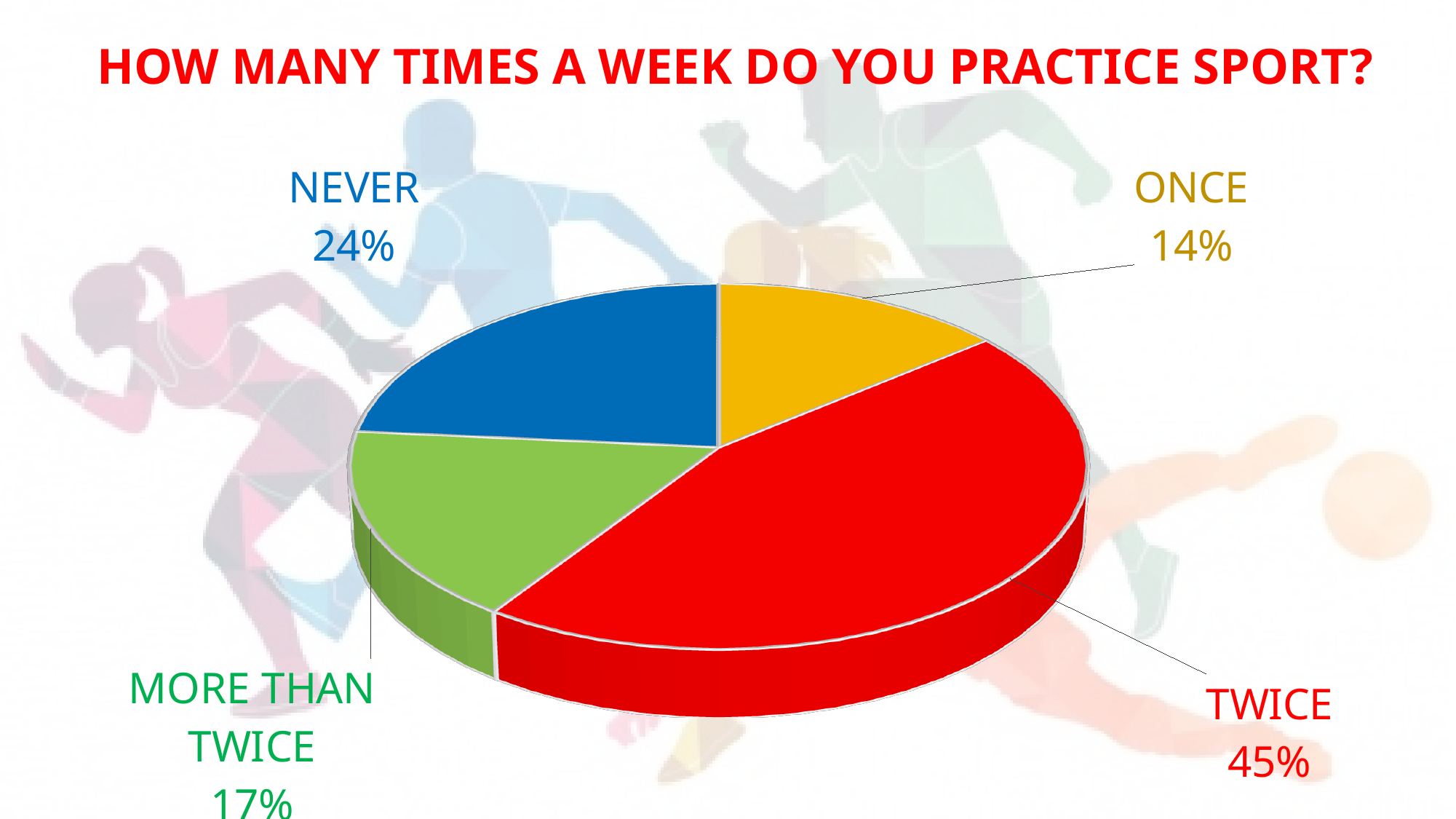
What percentage of respondents answered "TWICE"? 45% What is the title of the chart? HOW MANY TIMES A WEEK DO YOU PRACTICE SPORT? What percentage of respondents answered "MORE THAN TWICE"? 17% What kind of chart is shown on the slide? Pie chart What percentage of respondents answered "ONCE"? 14% What is the difference in percentage points between "TWICE" and "NEVER"? 21 Which is larger, the share for "NEVER" or the share for "MORE THAN TWICE"? NEVER What percentage of respondents answered "NEVER"? 24% What colour is the "TWICE" slice? Red Which answer has the smallest share of the pie? ONCE Which answer has the largest share of the pie? TWICE How many slices does the pie chart have? 4